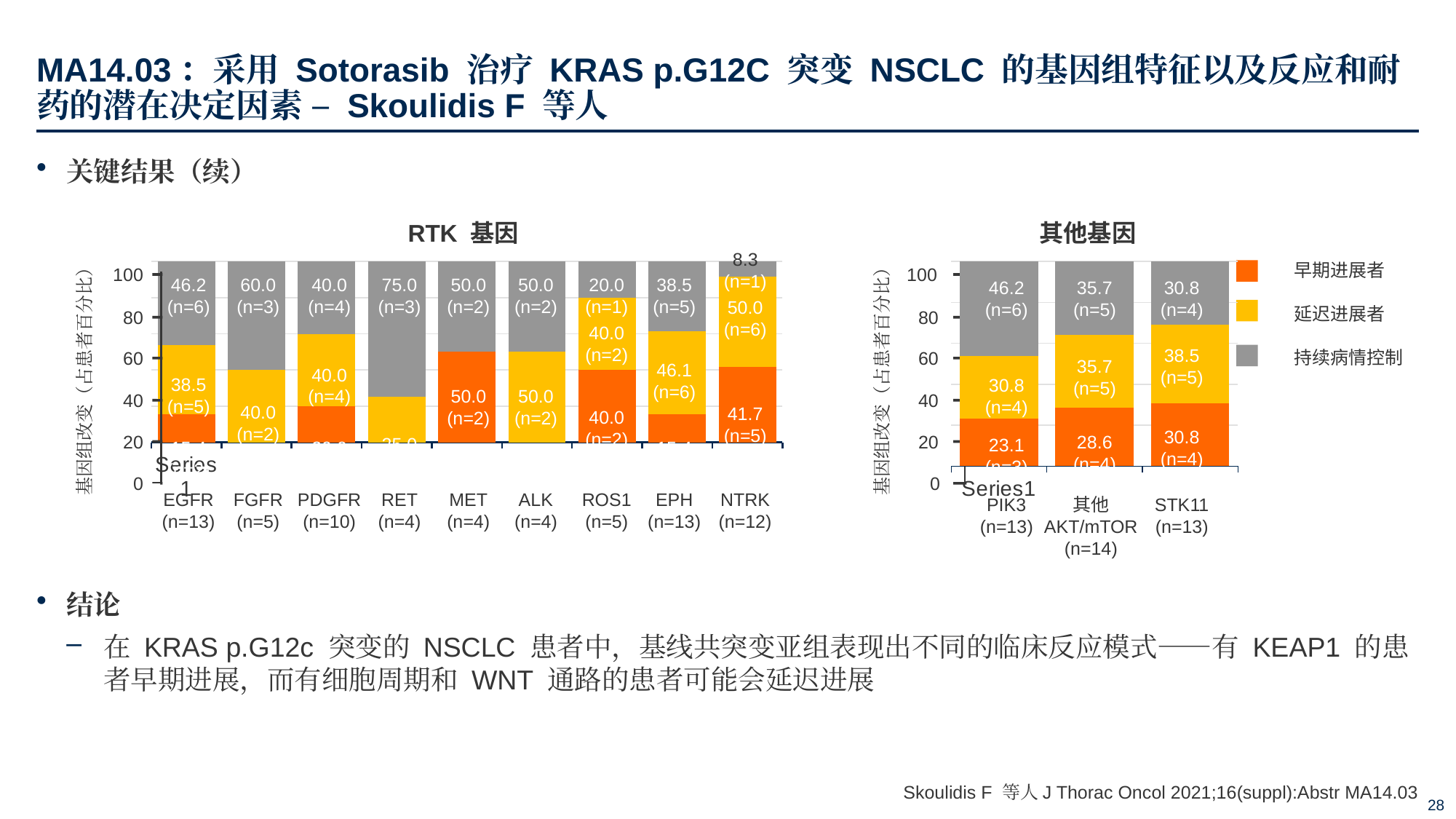
In the "其他基因" chart, is the 持续病情控制 percentage larger for PIK3 (n=13) or STK11 (n=13)? PIK3 (n=13) In the "RTK 基因" chart, which gene has the highest 持续病情控制 percentage? RET (n=4) In the "其他基因" chart, which colour represents 延迟进展者? Yellow How many series does the legend of the "其他基因" chart list? 3 In the "其他基因" chart, which gene has the highest 早期进展者 percentage? STK11 (n=13) In the "RTK 基因" chart, what is the 延迟进展者 percentage for NTRK (n=12)? 50.0 In the "其他基因" chart, what is the 早期进展者 percentage for PIK3 (n=13)? 23.1 In the "RTK 基因" chart, what is the difference between the 持续病情控制 percentages of FGFR (n=5) and ROS1 (n=5)? 40.0 In the "RTK 基因" chart, which gene has the lowest 持续病情控制 percentage? NTRK (n=12) In the "RTK 基因" chart, what is the 持续病情控制 percentage for RET (n=4)? 75.0 What kind of chart is the "RTK 基因" chart? Stacked bar chart How many gene categories are shown on the x axis of the "RTK 基因" chart? 9